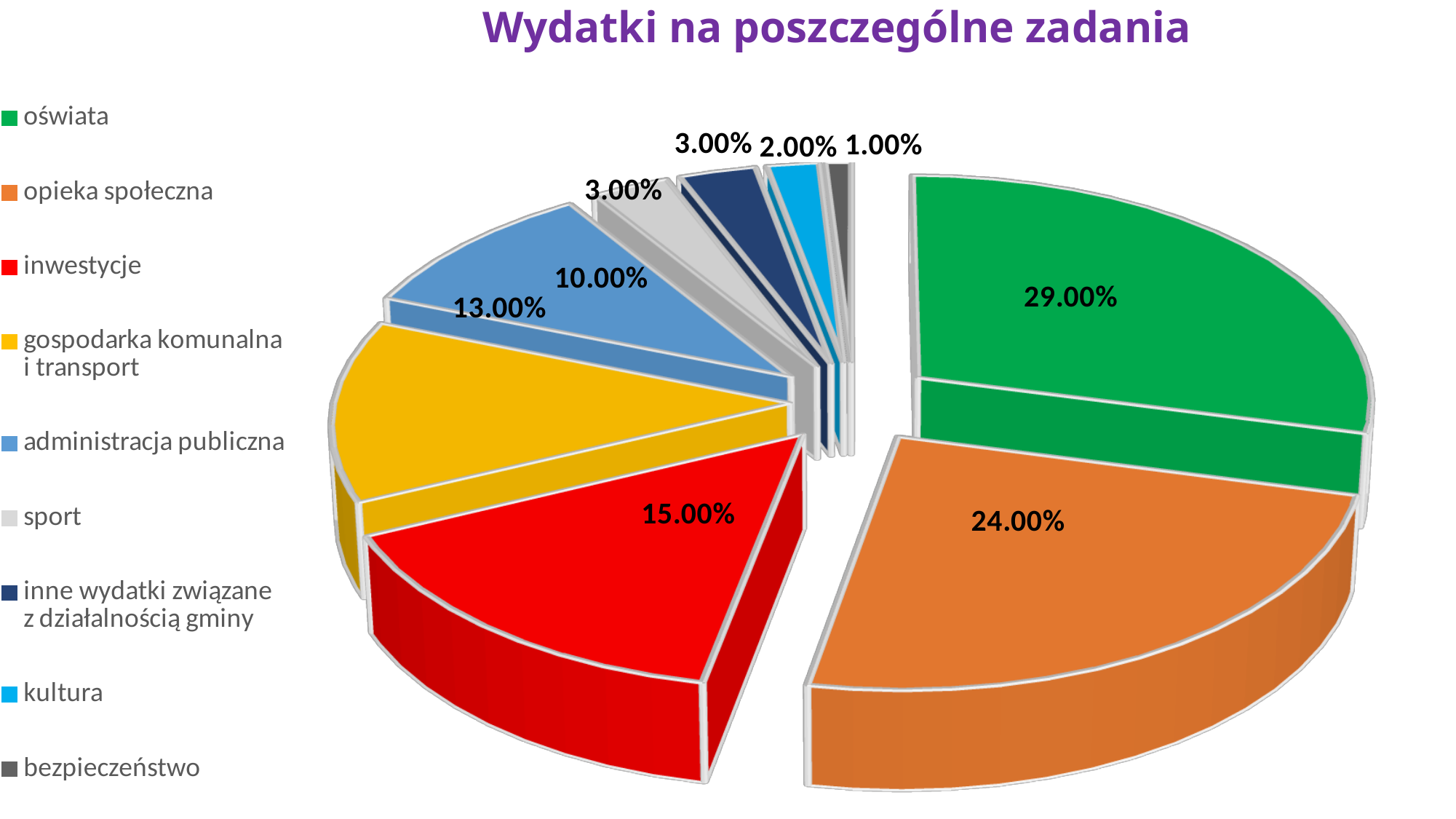
How many categories does the legend list? 9 What is the title of the chart? Wydatki na poszczególne zadania What share of the pie is gospodarka komunalna i transport? 13.00% What share of the pie is oświata? 29.00% Which is larger, inwestycje or administracja publiczna? inwestycje What share of the pie is administracja publiczna? 10.00% What share of the pie is inwestycje? 15.00% Which category has the largest slice? oświata What share of the pie is opieka społeczna? 24.00% What type of chart is shown on the slide? pie chart Which category has the smallest slice? bezpieczeństwo What is the difference in percentage points between oświata and opieka społeczna? 5.00%